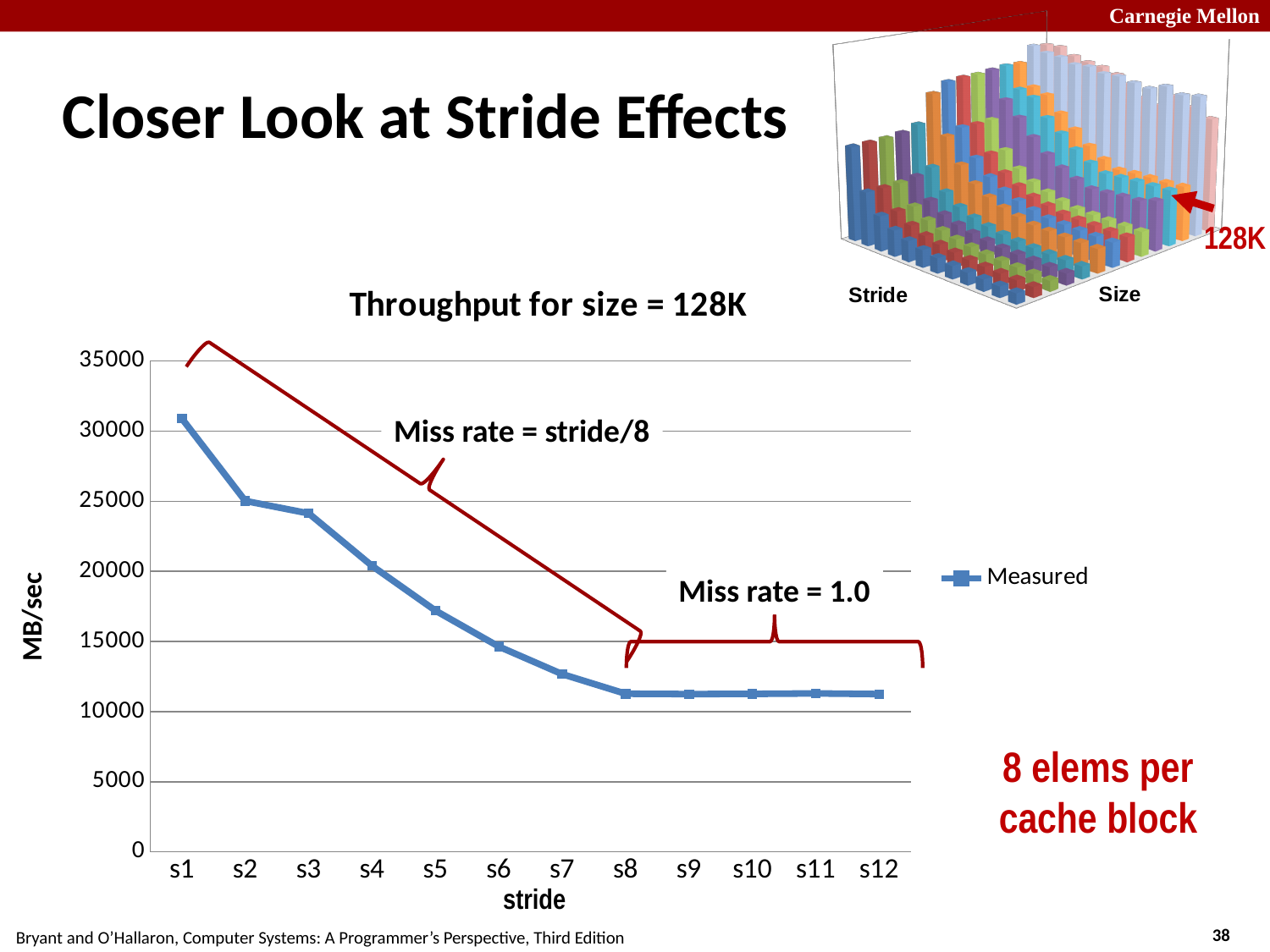
In the 'Throughput for size = 128K' chart, which stride has the highest throughput? s1 In the 'Throughput for size = 128K' chart, is the value for s8 greater or less than 10000? greater In the 'Throughput for size = 128K' chart, which has the larger value, s3 or s7? s3 In the 'Throughput for size = 128K' chart, how many stride categories are shown on the x axis? 12 What kind of chart is the 'Throughput for size = 128K' chart? line chart How many series does the legend of the 'Throughput for size = 128K' chart list? 1 In the 'Throughput for size = 128K' chart, which has the larger value, s1 or s4? s1 What is the name of the series in the legend of the 'Throughput for size = 128K' chart? Measured In the 'Throughput for size = 128K' chart, is the value for s3 greater or less than 25000? less What is the y-axis label of the 'Throughput for size = 128K' chart? MB/sec In the 'Throughput for size = 128K' chart, is the value for s5 greater or less than 15000? greater In the 'Throughput for size = 128K' chart, do the values rise or fall as stride increases from s1 to s8? fall